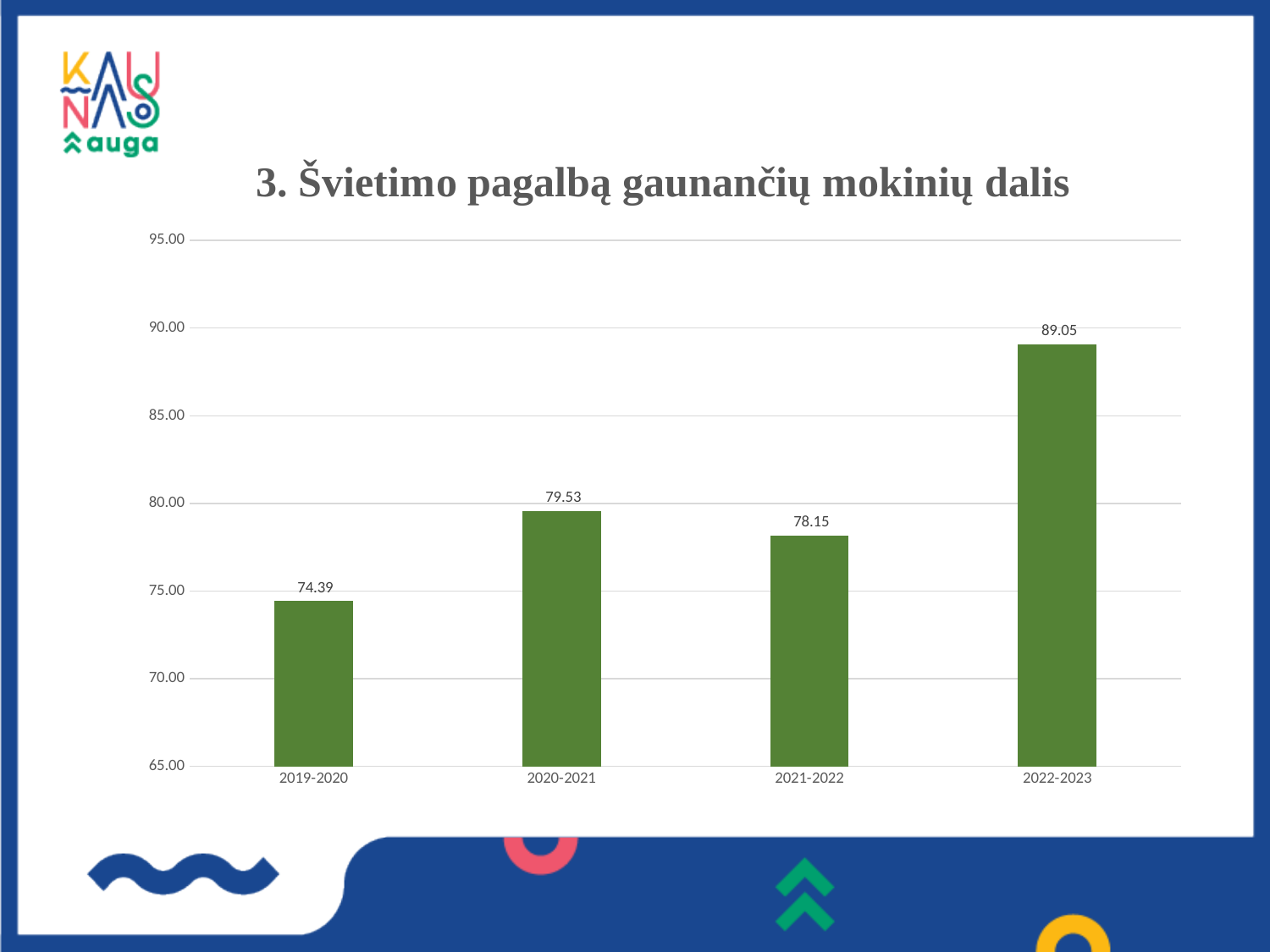
What is the title of the chart? 3. Švietimo pagalbą gaunančių mokinių dalis Which school year has the highest value? 2022-2023 Which school year has the lowest value? 2019-2020 What is the difference between the values for 2022-2023 and 2019-2020? 14.66 Is the value for 2021-2022 greater or less than 80.00? less How many school years are shown on the chart? 4 What is the value for 2021-2022? 78.15 What is the value for 2022-2023? 89.05 What kind of chart is shown on the slide? bar chart What is the value for 2020-2021? 79.53 What is the value for 2019-2020? 74.39 Which is larger, the value for 2020-2021 or the value for 2021-2022? 2020-2021